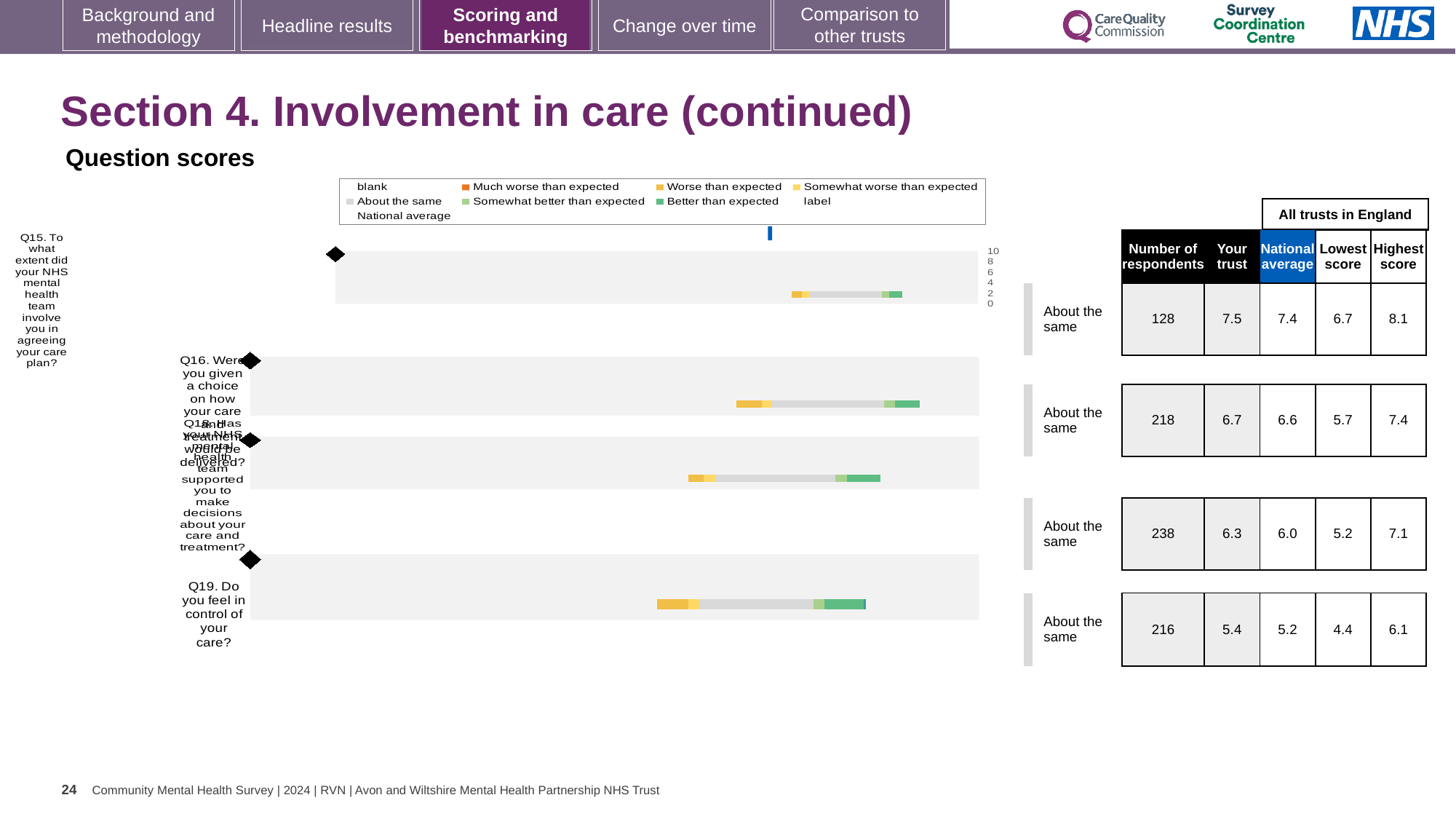
Which question has the lowest 'Your trust' score? Q19 For Q15, what is the difference between the highest score and the lowest score among all trusts in England? 1.4 What is the highest score among all trusts in England for Q19 (Do you feel in control of your care?)? 6.1 What benchmark category is shown for Q16 (Were you given a choice on how your care and treatment would be delivered?)? About the same What is the 'Your trust' score for Q16 (Were you given a choice on how your care and treatment would be delivered?)? 6.7 How many respondents answered Q15 (To what extent did your NHS mental health team involve you in agreeing your care plan?)? 128 What is the national average score for Q18 (Has your NHS mental health team supported you to make decisions about your care and treatment?)? 6.0 How many questions are plotted in the question scores chart? 4 Which question has the highest 'Your trust' score? Q15 What is the lowest score among all trusts in England for Q19 (Do you feel in control of your care?)? 4.4 What kind of chart is used to show the question scores on this slide? Bar chart For Q18, which is larger: the 'Your trust' score or the national average? Your trust